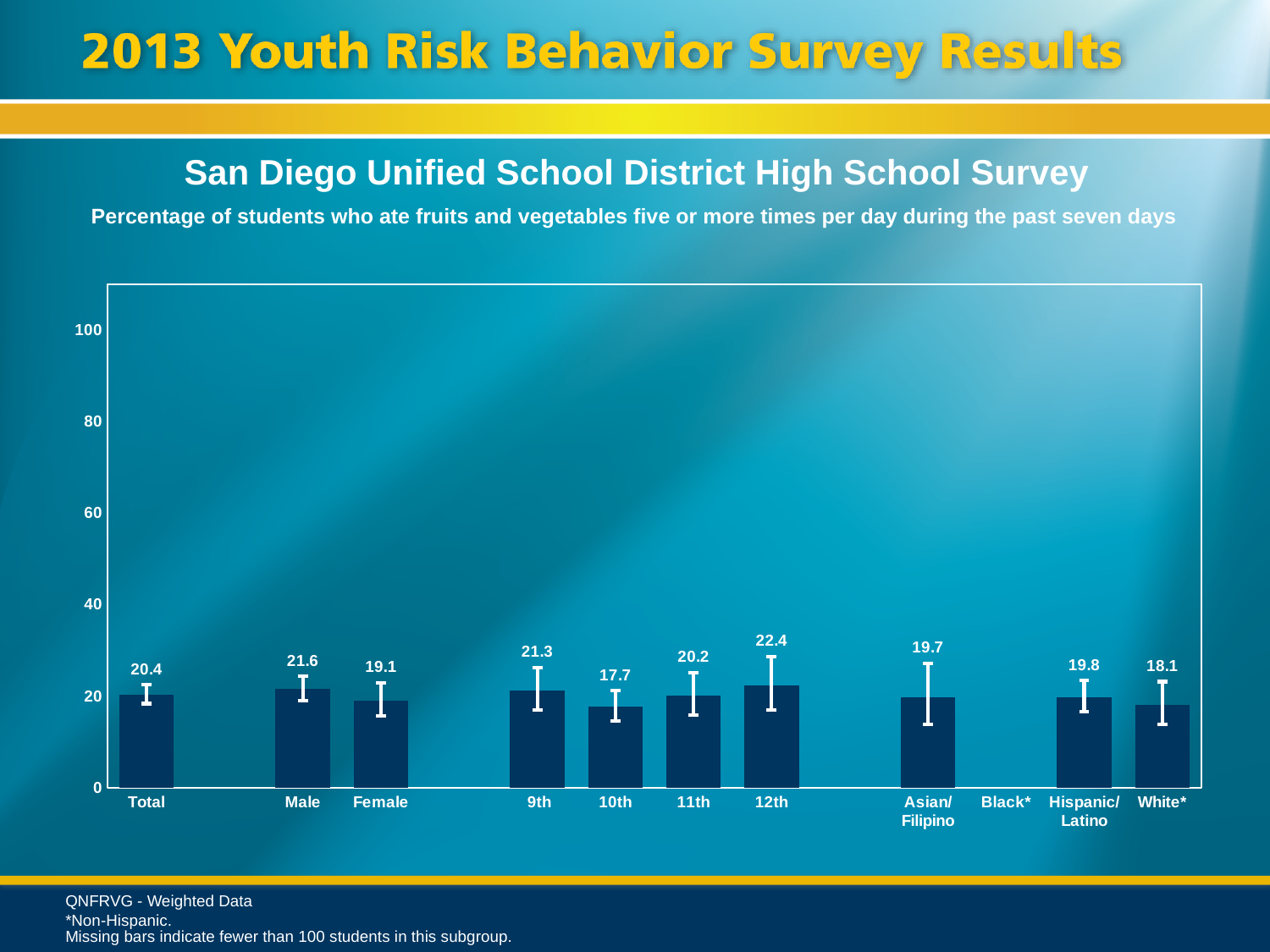
Which is larger, the value for 9th or the value for 11th? 9th What is the value for Hispanic/Latino? 19.8 Which category has no bar shown? Black* What is the value for Total? 20.4 What is the value for 10th grade? 17.7 What kind of chart is this? bar chart Which category with a bar has the lowest value? 10th What is the difference between the Male and Female values? 2.5 Is the value for 12th greater or less than 40? less How many categories are labeled on the x axis? 11 Which category has the highest value? 12th What is the value for Male? 21.6